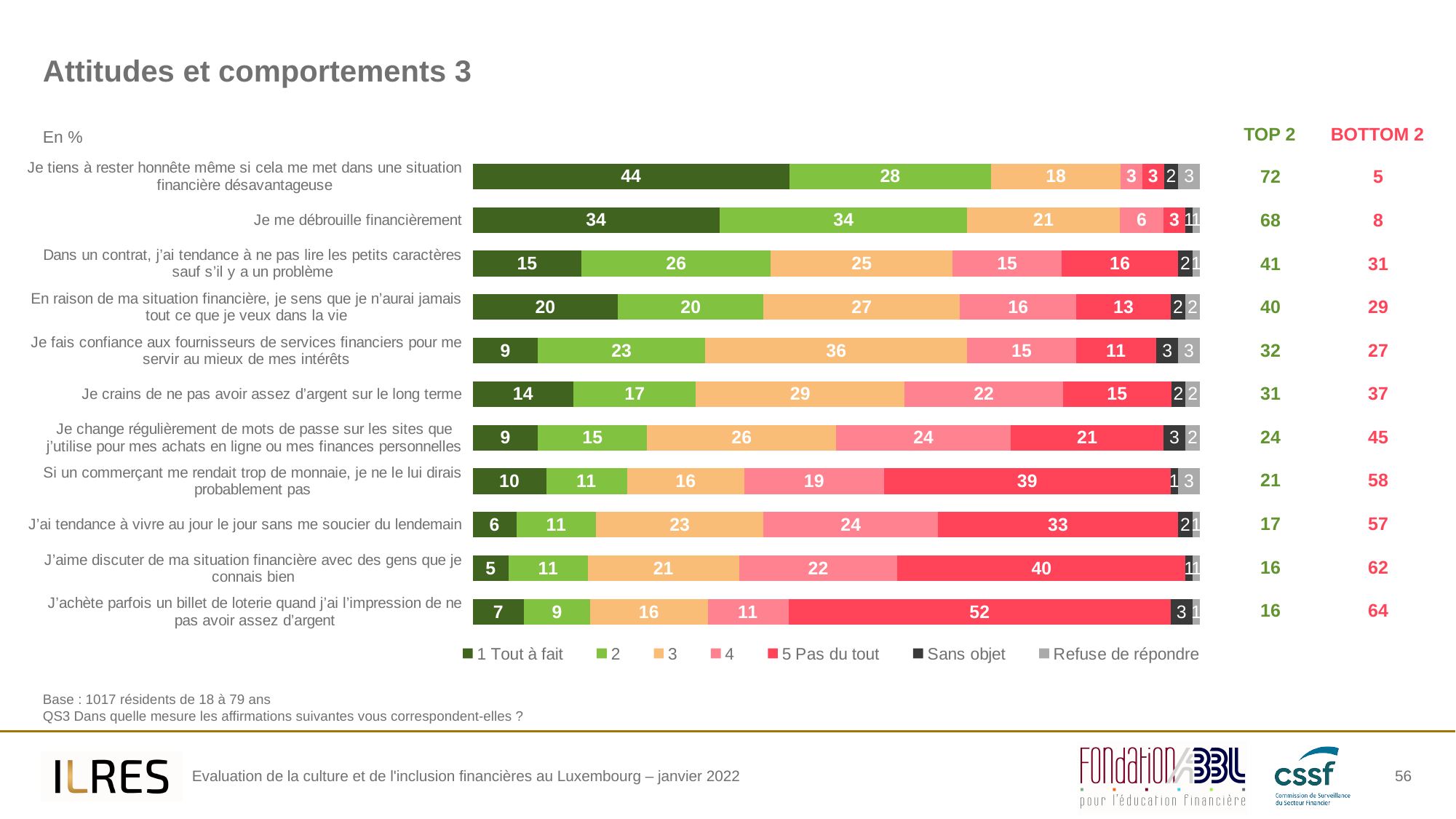
What is the value of series "3" for "Je fais confiance aux fournisseurs de services financiers pour me servir au mieux de mes intérêts"? 36 Which has the larger "5 Pas du tout" value: "Si un commerçant me rendait trop de monnaie, je ne le lui dirais probablement pas" or "J'ai tendance à vivre au jour le jour sans me soucier du lendemain"? Si un commerçant me rendait trop de monnaie, je ne le lui dirais probablement pas What is the value of "5 Pas du tout" for "J'achète parfois un billet de loterie quand j'ai l'impression de ne pas avoir assez d'argent"? 52 What is the difference between the "1 Tout à fait" values for "Je tiens à rester honnête..." and "Je me débrouille financièrement"? 10 Which statement has the lowest value for "1 Tout à fait"? J'aime discuter de ma situation financière avec des gens que je connais bien In what unit are the chart values expressed, according to the label above the chart? En % What is the difference between the "5 Pas du tout" values for "J'achète parfois un billet de loterie..." and "J'aime discuter de ma situation financière..."? 12 What is the value of "1 Tout à fait" for "Je tiens à rester honnête même si cela me met dans une situation financière désavantageuse"? 44 Which statement has the highest value for "5 Pas du tout"? J'achète parfois un billet de loterie quand j'ai l'impression de ne pas avoir assez d'argent How many statements (categories) are plotted in the chart? 11 What kind of chart is shown on the slide? Stacked bar chart How many series does the legend list? 7